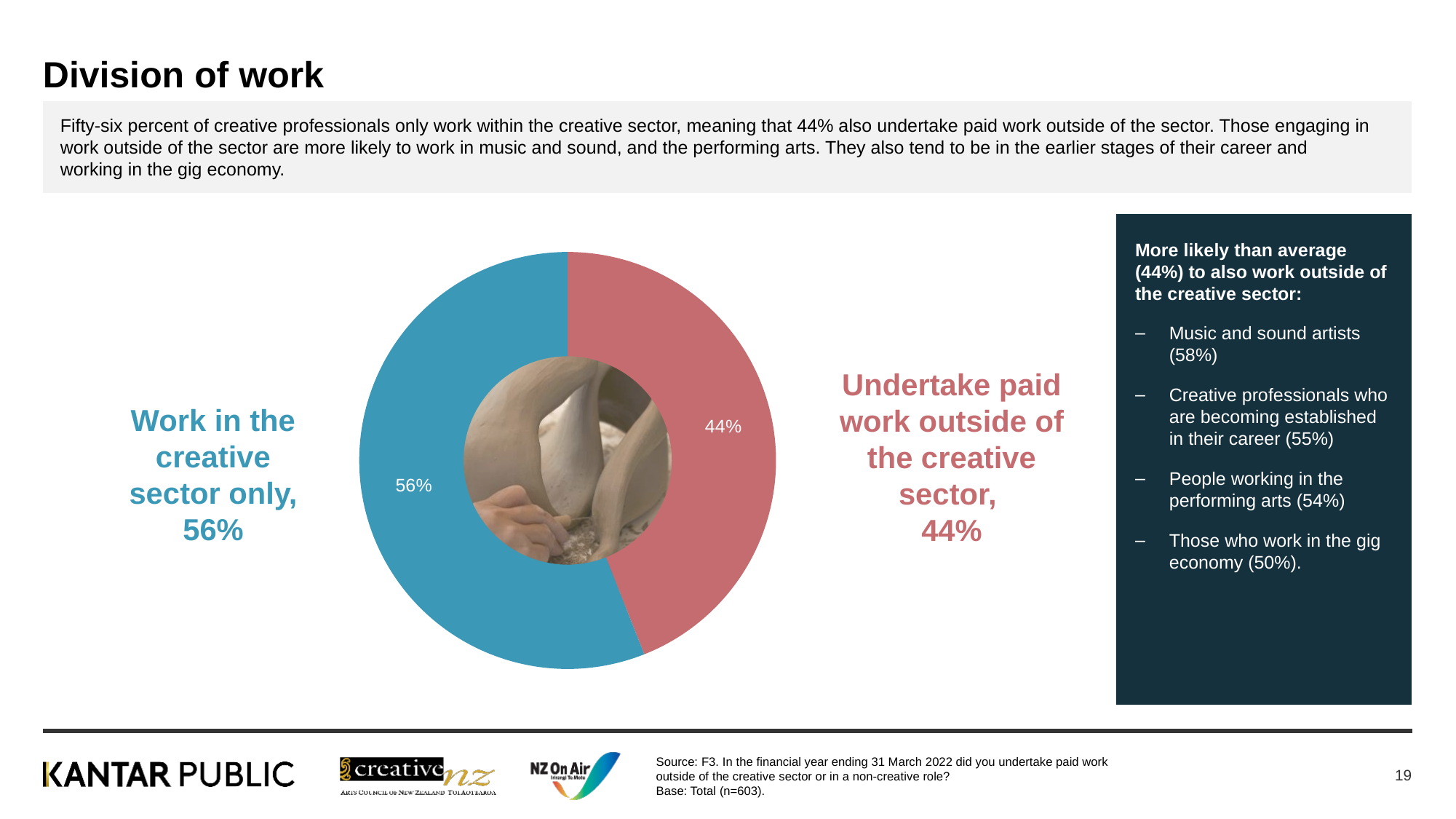
How many segments does the chart have? 2 What kind of chart is shown on the slide? Pie chart (doughnut) What colour is the segment representing those who undertake paid work outside of the creative sector? Red Is the share of creative professionals who undertake paid work outside the creative sector greater or less than 50%? less What colour is the segment representing those who work in the creative sector only? Blue Which category has the smallest share of the chart? Undertake paid work outside of the creative sector Which segment of the chart is larger: working in the creative sector only, or undertaking paid work outside the creative sector? Work in the creative sector only What is the combined total of the two segments shown in the chart? 100% What percentage of creative professionals undertake paid work outside of the creative sector? 44% What percentage of creative professionals work in the creative sector only? 56% What is the difference in percentage points between the two segments of the chart? 12 percentage points